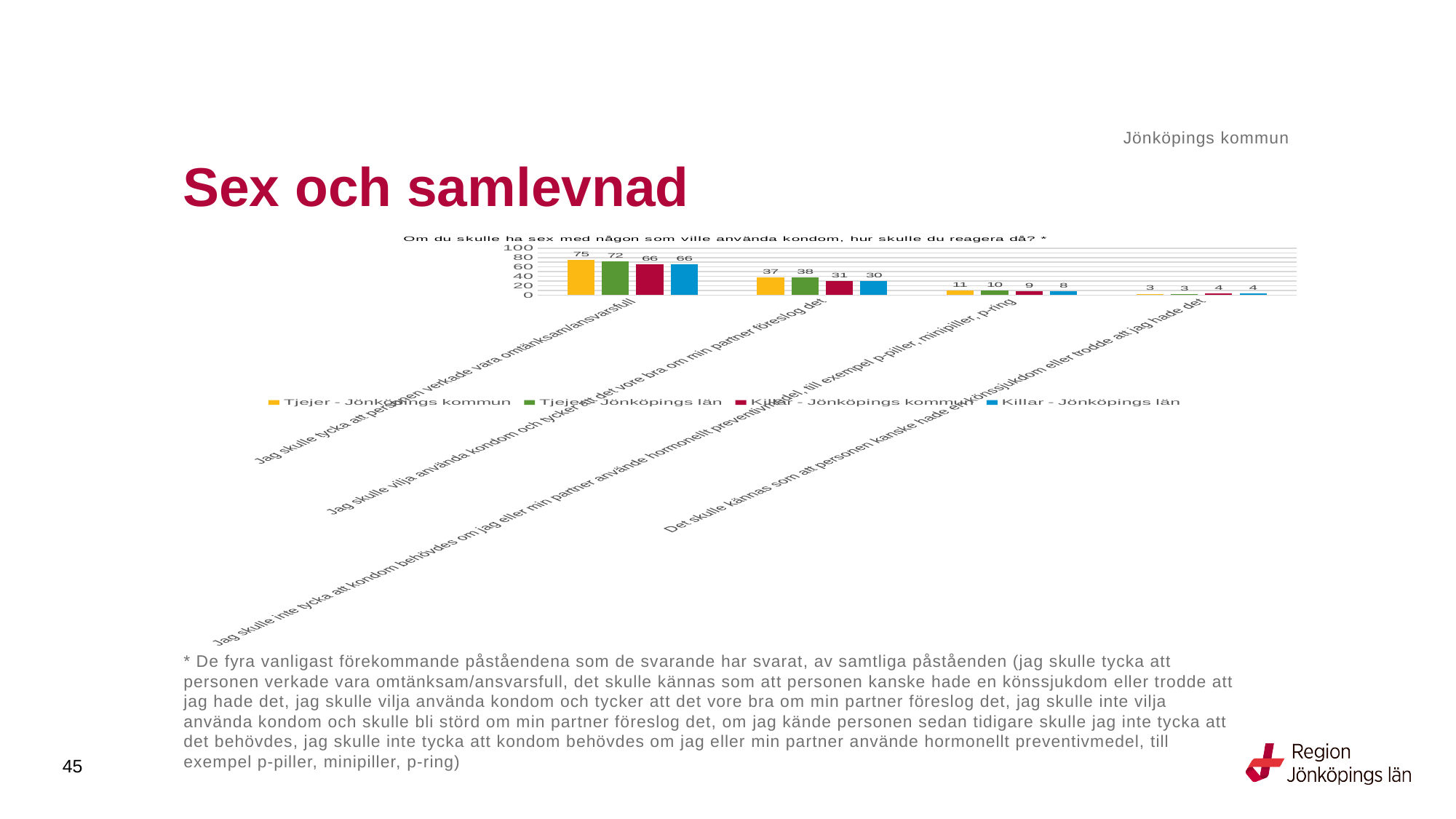
For the statement "Jag skulle vilja använda kondom och tycker att det vore bra om min partner föreslog det", which is larger: Tjejer - Jönköpings kommun or Killar - Jönköpings kommun? Tjejer - Jönköpings kommun Which statement has the lowest value for Killar - Jönköpings län? Det skulle kännas som att personen kanske hade en könssjukdom eller trodde att jag hade det What is the value for Tjejer - Jönköpings kommun for the statement "Jag skulle tycka att personen verkade vara omtänksam/ansvarsfull"? 75 What is the value for Tjejer - Jönköpings län for the statement "Jag skulle inte tycka att kondom behövdes om jag eller min partner använde hormonellt preventivmedel"? 10 What kind of chart is shown on the slide? Bar chart What is the value for Killar - Jönköpings län for the statement "Jag skulle vilja använda kondom och tycker att det vore bra om min partner föreslog det"? 30 What is the difference between Tjejer - Jönköpings kommun and Killar - Jönköpings kommun for the statement "Jag skulle tycka att personen verkade vara omtänksam/ansvarsfull"? 9 Which colour represents Killar - Jönköpings län in the chart? Blue How many statements (categories) are shown on the x axis of the chart? 4 How many series does the chart legend list? 4 What is the value for Killar - Jönköpings kommun for the statement "Det skulle kännas som att personen kanske hade en könssjukdom eller trodde att jag hade det"? 4 Which statement has the highest value for Tjejer - Jönköpings kommun? Jag skulle tycka att personen verkade vara omtänksam/ansvarsfull